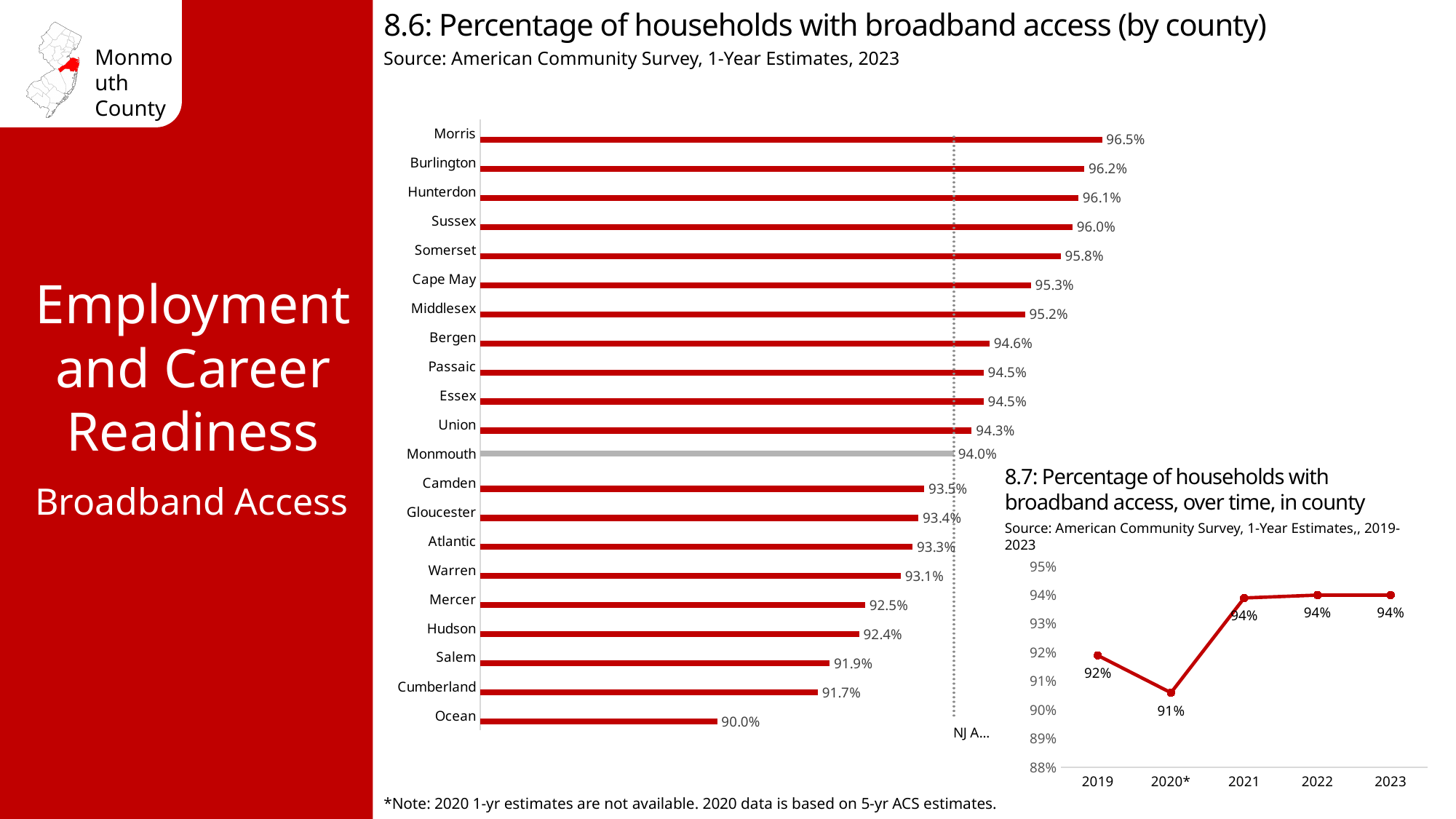
What kind of chart is chart 8.6 (Percentage of households with broadband access by county)? Bar chart In chart 8.7 (broadband access over time in county), what is the difference between the 2021 and 2019 values? 2 percentage points In chart 8.7 (broadband access over time in county), how many years are plotted? 5 In chart 8.6 (by county), which county has the highest percentage of households with broadband access? Morris In chart 8.6 (Percentage of households with broadband access by county), what is the value for Monmouth? 94.0% In chart 8.7 (broadband access over time in county), what is the value for 2020*? 91% In chart 8.6 (by county), which has a higher value, Bergen or Mercer? Bergen In chart 8.6 (by county), which county has the lowest percentage of households with broadband access? Ocean In chart 8.6 (by county), how many counties are shown? 21 In chart 8.6 (by county), what is the difference between the values for Morris and Ocean? 6.5 percentage points What kind of chart is chart 8.7 (Percentage of households with broadband access over time in county)? Line chart In chart 8.6 (by county), what is the value for Cumberland? 91.7%